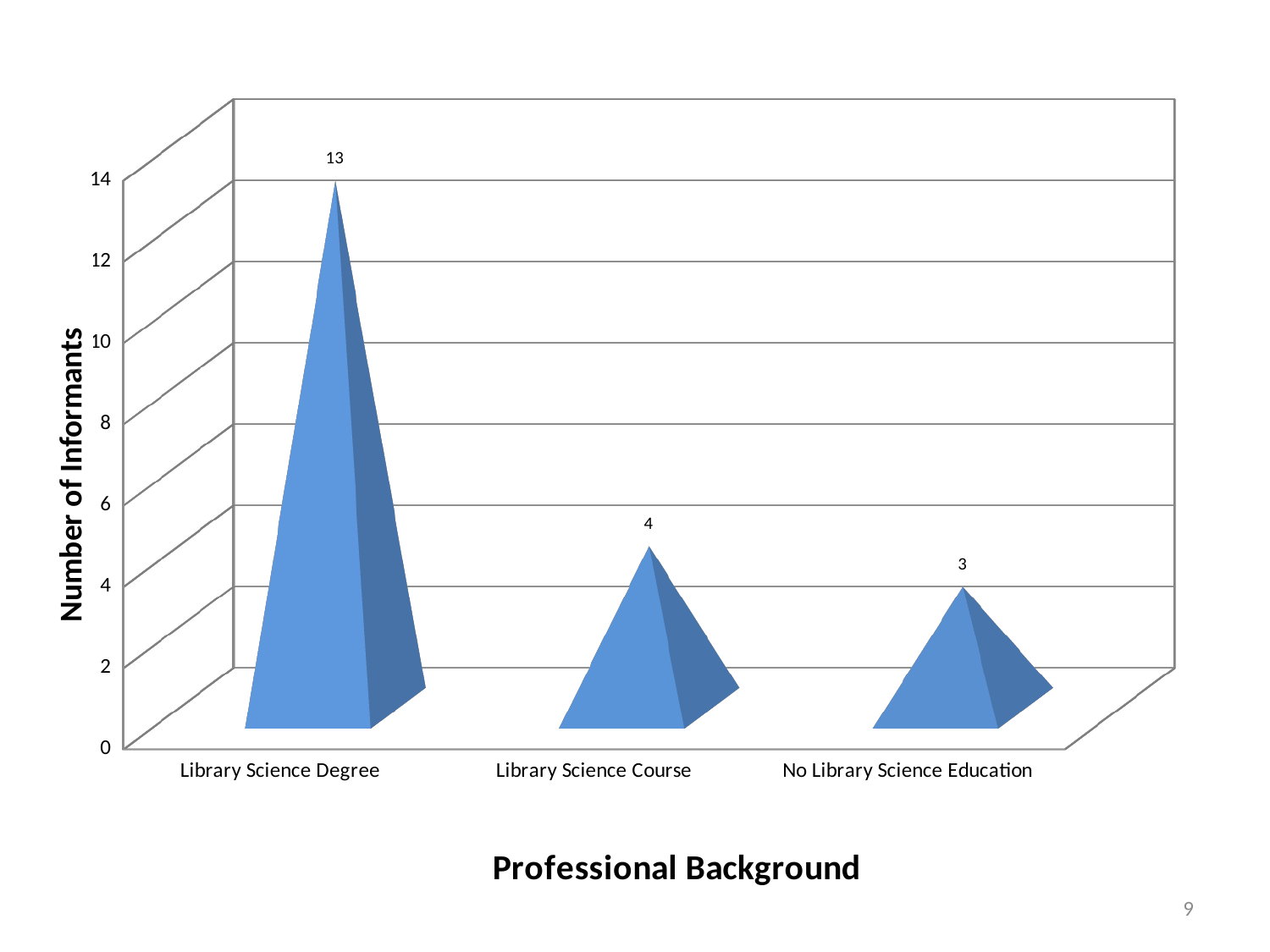
What is the difference between the values for Library Science Course and No Library Science Education? 1 How many categories are shown on the x axis? 3 Which is larger: the value for Library Science Degree or the value for No Library Science Education? Library Science Degree Which professional background category has the lowest number of informants? No Library Science Education Is the value for Library Science Degree greater or less than 10? greater What is the value for Library Science Course? 4 Which professional background category has the highest number of informants? Library Science Degree What is the difference between the number of informants with a Library Science Degree and those with a Library Science Course? 9 How many informants have a Library Science Degree? 13 What is the value for No Library Science Education? 3 What kind of chart is shown on the slide? bar chart What is the label of the x axis? Professional Background